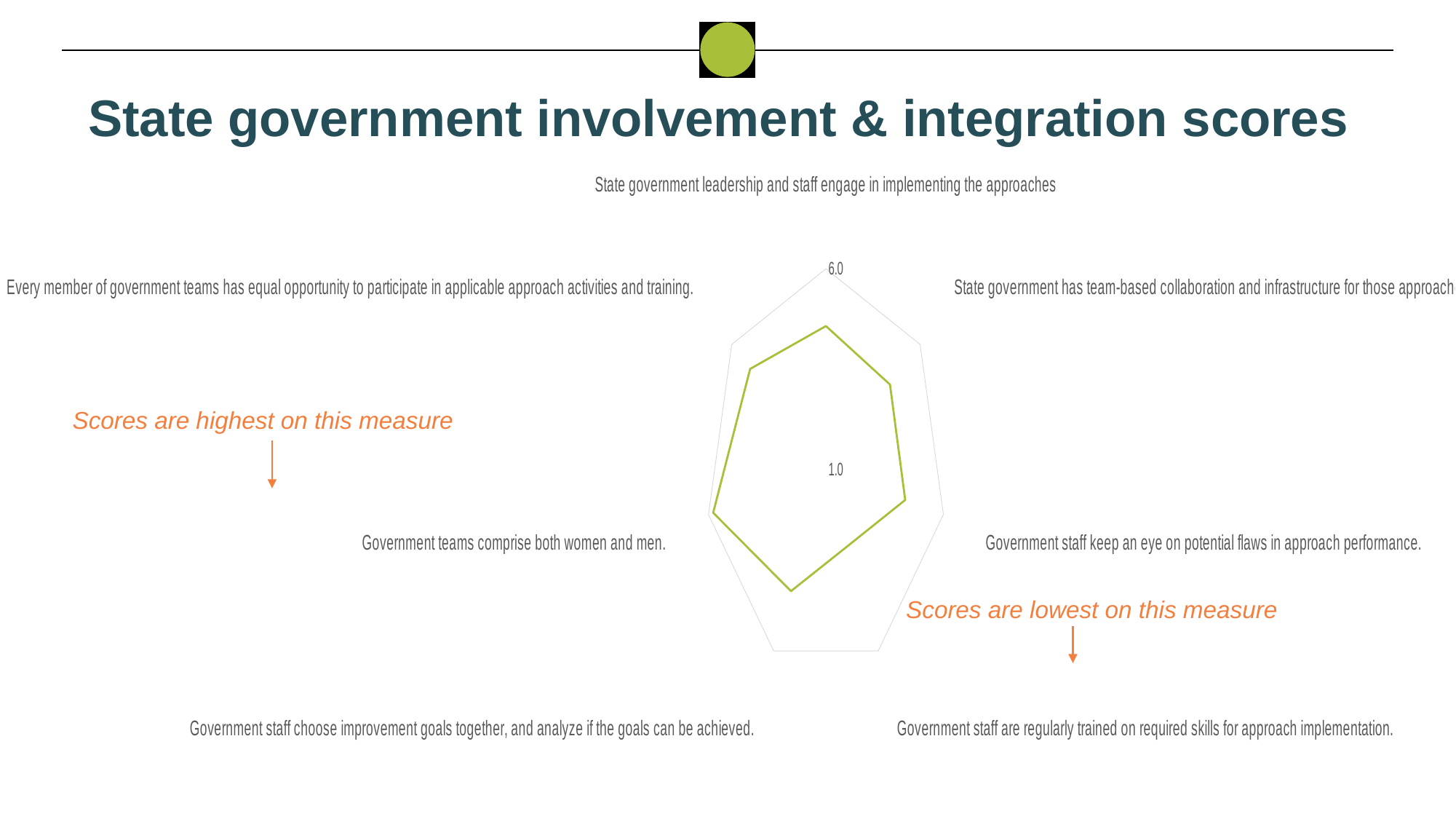
On which measure are scores highest? Government teams comprise both women and men. Is the score for 'Government staff are regularly trained on required skills for approach implementation' greater or less than 1.0? greater Which has the larger score: 'Government teams comprise both women and men' or 'Government staff are regularly trained on required skills for approach implementation'? Government teams comprise both women and men. What kind of chart is shown on the slide? radar chart How many measures (axes) does the radar chart plot? 7 What value is shown at the outer ring of the radar chart? 6.0 What is the title of the slide containing the radar chart? State government involvement & integration scores On which measure are scores lowest? Government staff are regularly trained on required skills for approach implementation.